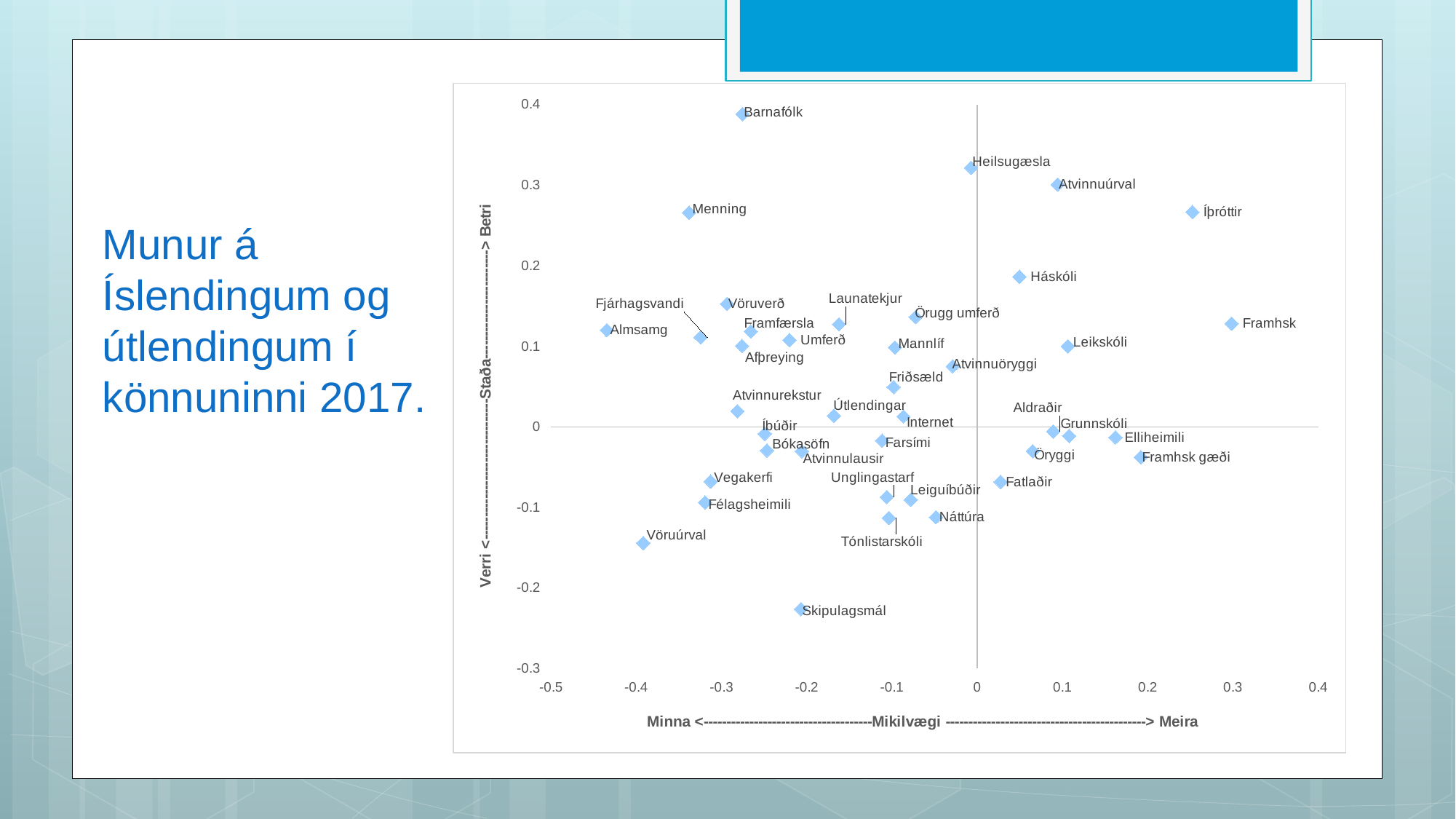
Is the horizontal value for Íþróttir greater or less than 0.2? greater Is the vertical value for Barnafólk greater or less than 0.3? greater Is the horizontal value for Vöruúrval greater or less than -0.3? less Which labelled point has the lowest vertical (Staða) value? Skipulagsmál What is the label of the horizontal axis? Minna <---Mikilvægi---> Meira Which point is higher on the vertical axis, Barnafólk or Heilsugæsla? Barnafólk Which labelled point lies furthest to the left on the horizontal (Mikilvægi) axis? Almsamg Which labelled point has the highest vertical (Staða) value? Barnafólk What kind of chart is shown on the slide? scatter chart Which labelled point lies furthest to the right on the horizontal (Mikilvægi) axis? Framhsk